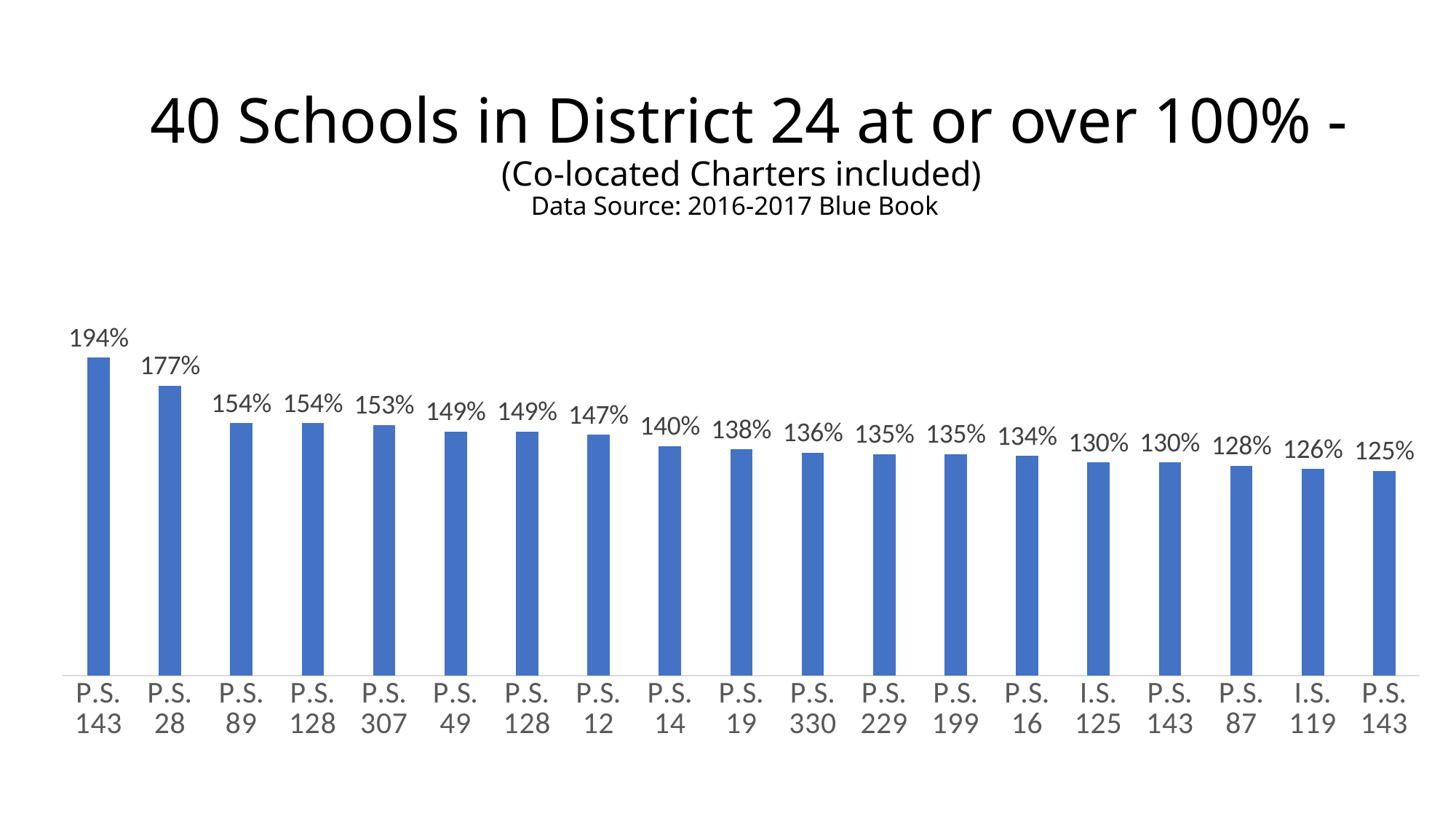
Which has a larger value, P.S. 14 or P.S. 19? P.S. 14 What is the difference between the values for P.S. 28 and P.S. 89? 23% What is the lowest value shown in the chart? 125% What type of chart is shown on the slide? bar chart What is the value shown for the first (leftmost) bar, P.S. 143? 194% What is the value shown for I.S. 119? 126% Do the values rise or fall from left to right along the x axis? fall Which school has the highest value in the chart? P.S. 143 (leftmost bar) What is the value shown for P.S. 12? 147% How many bars are plotted in the chart? 19 What is the value shown for P.S. 307? 153% What is the value shown for P.S. 28? 177%